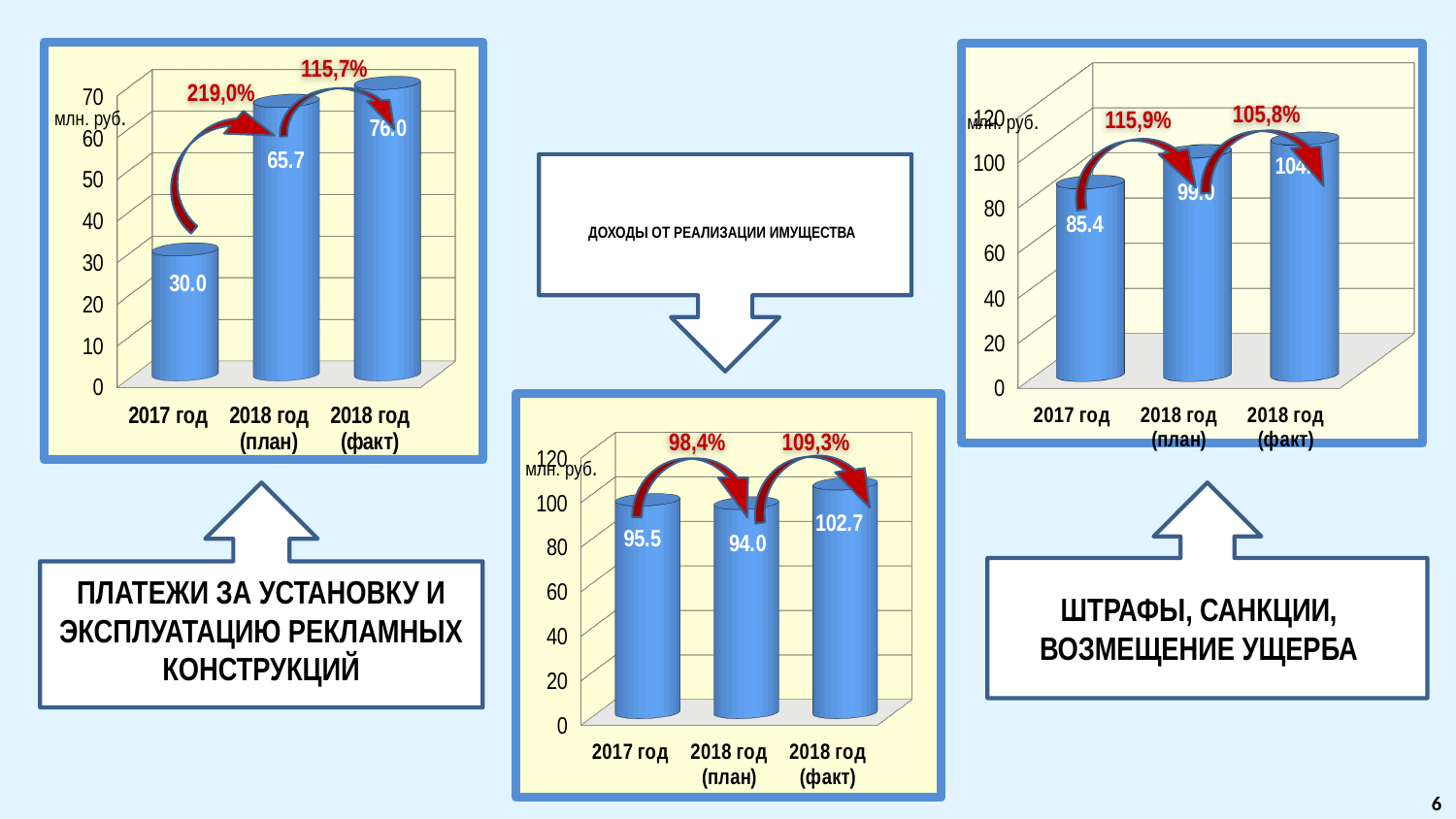
On the left chart (Платежи за установку и эксплуатацию рекламных конструкций), what is the value for 2017 год? 30.0 On the right chart (Штрафы, санкции, возмещение ущерба), what is the value for 2017 год? 85.4 On the left chart (Платежи за установку и эксплуатацию рекламных конструкций), what is the difference between 2018 год (факт) and 2017 год? 46.0 On the middle chart (Доходы от реализации имущества), what is the value for 2017 год? 95.5 On the left chart (Платежи за установку и эксплуатацию рекламных конструкций), what is the value for 2018 год (план)? 65.7 How many categories are shown on the left chart (Платежи за установку и эксплуатацию рекламных конструкций)? 3 On the left chart (Платежи за установку и эксплуатацию рекламных конструкций), which category has the lowest value? 2017 год On the right chart (Штрафы, санкции, возмещение ущерба), is the value for 2018 год (факт) greater or less than 100? greater On the left chart (Платежи за установку и эксплуатацию рекламных конструкций), what is the value for 2018 год (факт)? 76.0 On the middle chart (Доходы от реализации имущества), what is the difference between 2018 год (факт) and 2018 год (план)? 8.7 On the middle chart (Доходы от реализации имущества), what is the value for 2018 год (факт)? 102.7 On the middle chart (Доходы от реализации имущества), which category has the highest value? 2018 год (факт)